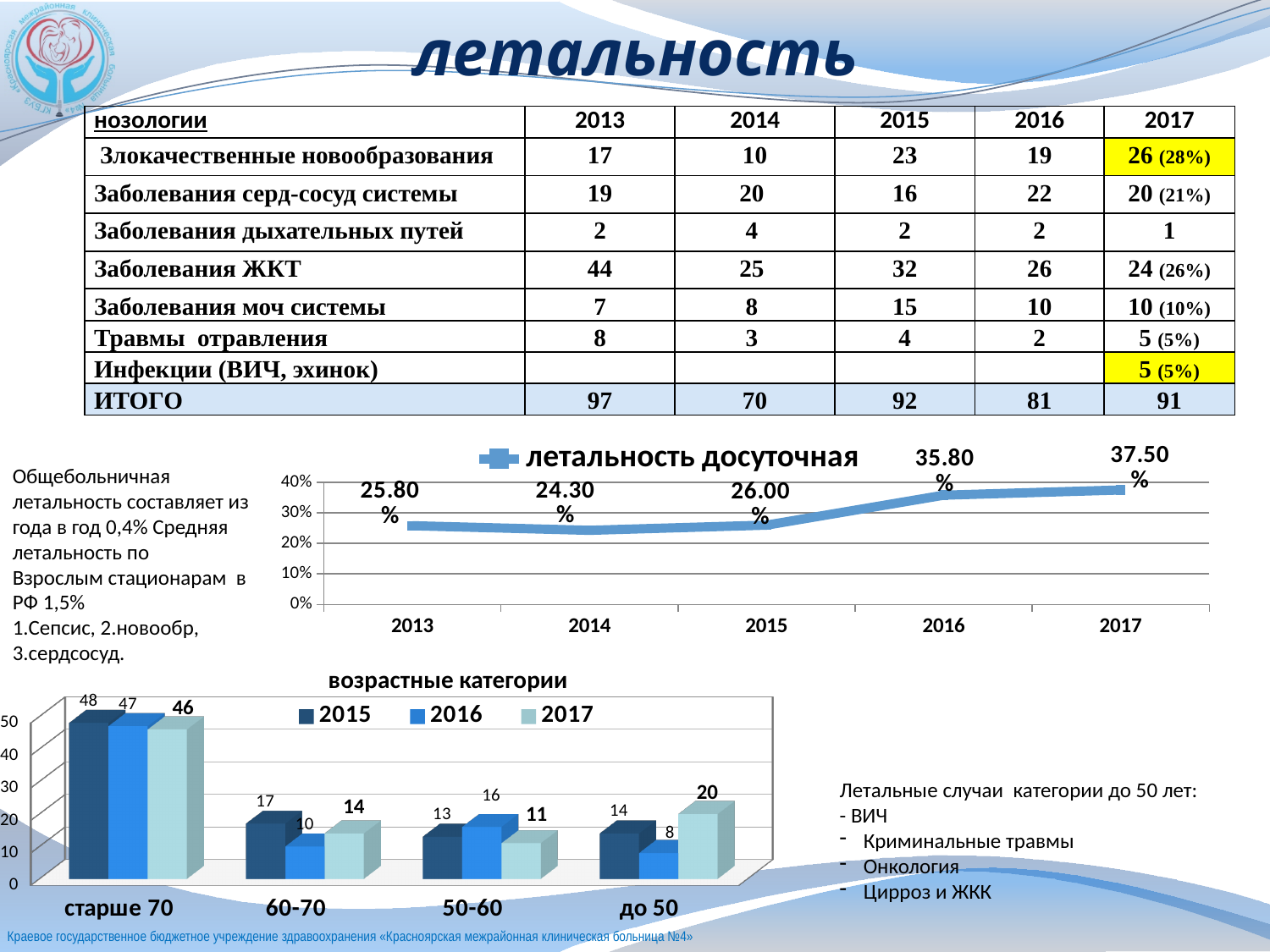
On the chart titled "летальность досуточная", how many years are plotted on the x axis? 5 On the chart titled "летальность досуточная", what is the value for 2014? 24.30% On the chart titled "летальность досуточная", what is the difference between the 2017 and 2013 values? 11.70% On the chart titled "возрастные категории", what is the value for 2016 in the "60-70" category? 10 On the chart titled "возрастные категории", which category has the highest value for 2015? старше 70 On the chart titled "возрастные категории", what is the value for 2017 in the "до 50" category? 20 On the chart titled "летальность досуточная", which year has the lowest value? 2014 On the chart titled "возрастные категории", how many series does the legend list? 3 On the chart titled "летальность досуточная", what is the value for 2017? 37.50% On the chart titled "летальность досуточная", does the value rise or fall from 2015 to 2017? rise On the chart titled "возрастные категории", which is larger in the "50-60" category: the 2016 value or the 2017 value? 2016 On the chart titled "возрастные категории", what kind of chart is it? bar chart